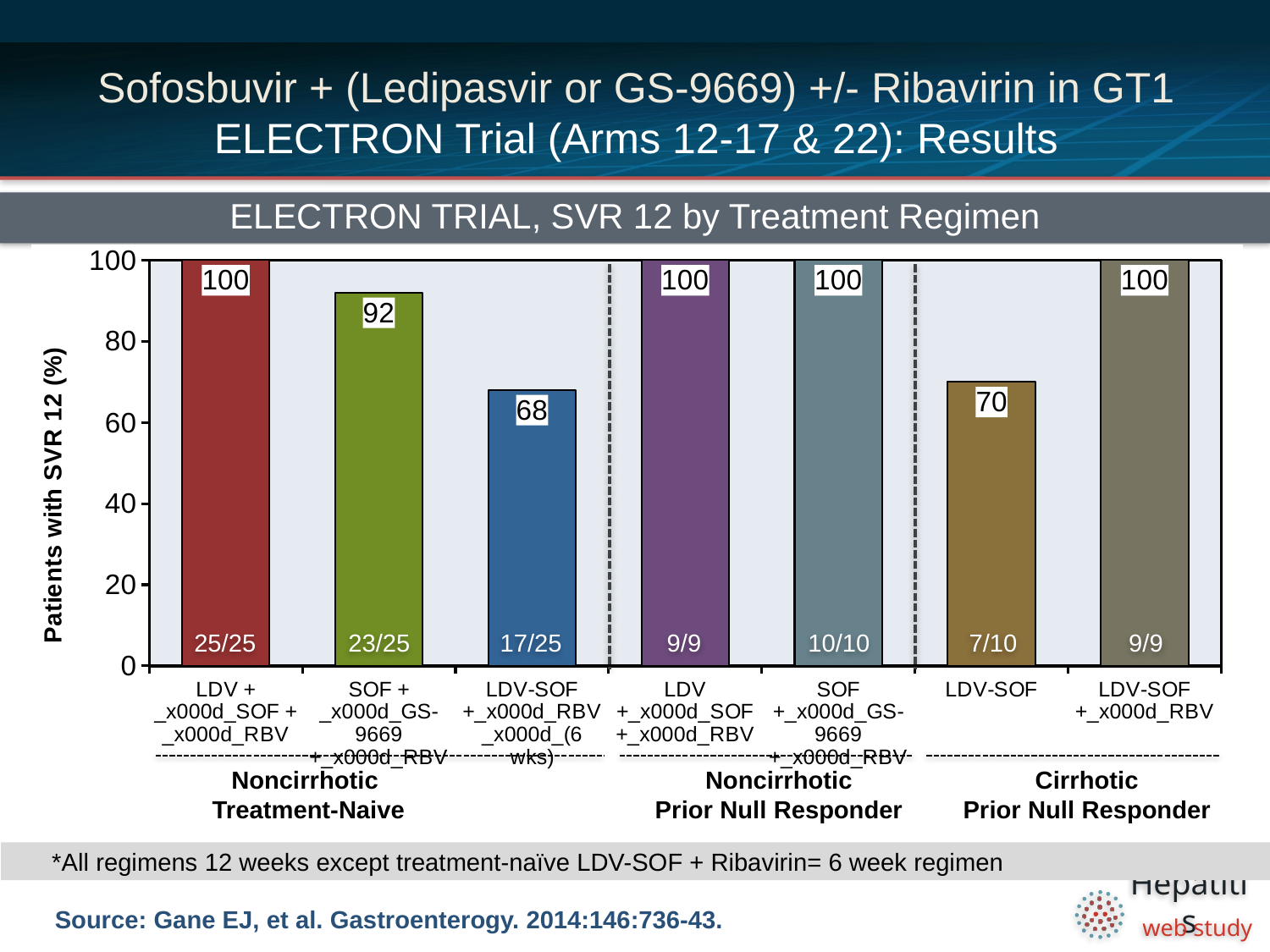
How many patients achieved SVR 12 with SOF + GS-9669 + RBV in the Noncirrhotic Prior Null Responder group, as shown at the base of the bar? 10/10 What is the label of the y-axis? Patients with SVR 12 (%) What is the SVR 12 rate for LDV-SOF in the Cirrhotic Prior Null Responder group? 70 What type of chart is shown on the slide? Bar chart In the Cirrhotic Prior Null Responder group, which regimen has the higher SVR 12 rate, LDV-SOF or LDV-SOF + RBV? LDV-SOF + RBV How many bars on the chart show an SVR 12 rate of 100? 4 What is the SVR 12 rate for LDV-SOF + RBV (6 wks) in the Noncirrhotic Treatment-Naive group? 68 How many bars are plotted on the chart? 7 What is the SVR 12 rate for SOF + GS-9669 + RBV in the Noncirrhotic Treatment-Naive group? 92 Which regimen has the lowest SVR 12 rate on the chart? LDV-SOF + RBV (6 wks), Noncirrhotic Treatment-Naive What is the difference in SVR 12 rate between SOF + GS-9669 + RBV and LDV-SOF + RBV (6 wks) in the Noncirrhotic Treatment-Naive group? 24 What is the title of the chart? ELECTRON TRIAL, SVR 12 by Treatment Regimen